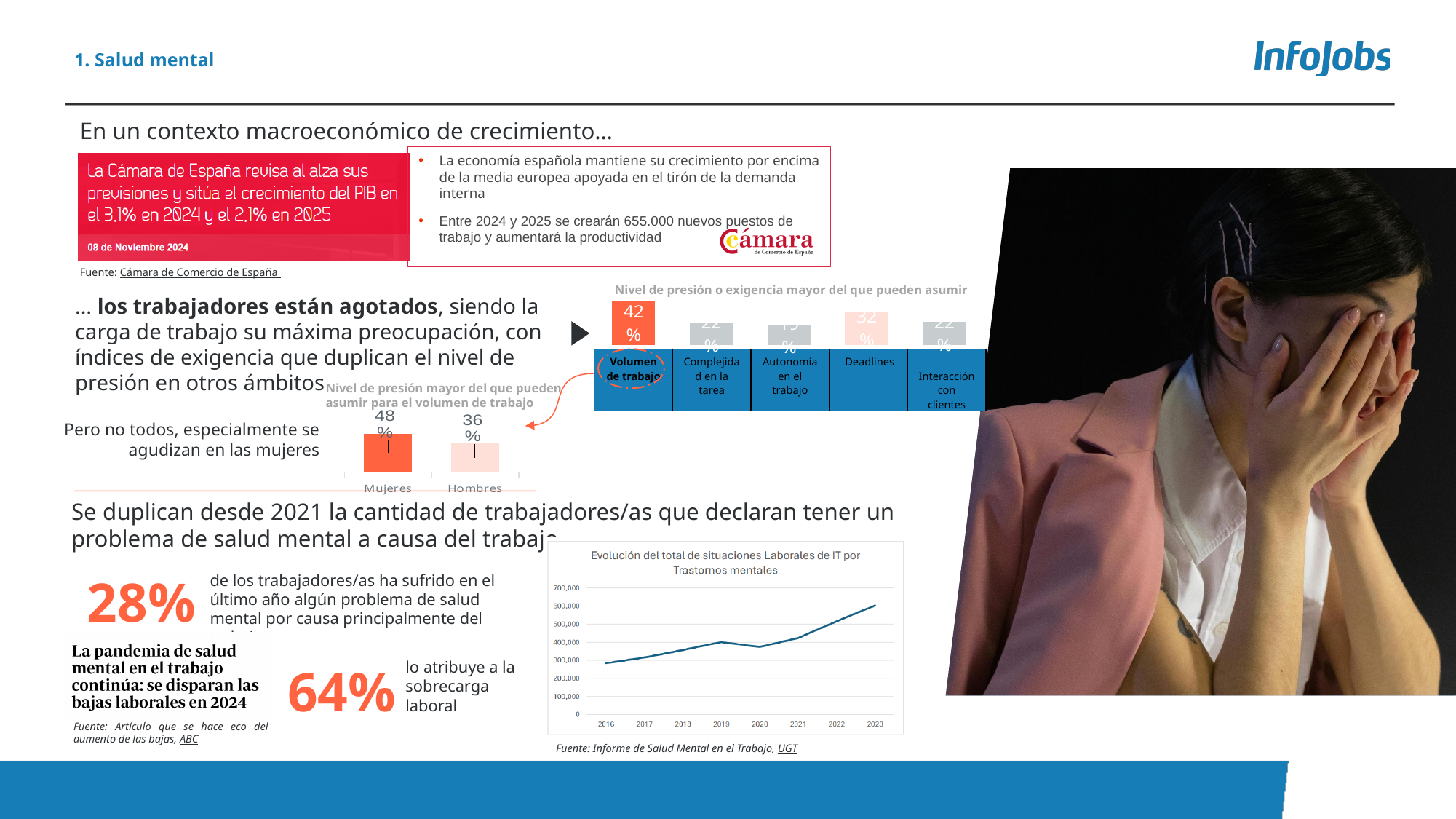
In the chart 'Nivel de presión mayor del que pueden asumir para el volumen de trabajo', what is the difference between Mujeres and Hombres? 12% In the chart 'Nivel de presión o exigencia mayor del que pueden asumir', what is the difference between Volumen de trabajo and Deadlines? 10% In the chart 'Nivel de presión mayor del que pueden asumir para el volumen de trabajo', what is the value for Hombres? 36% In the chart 'Nivel de presión mayor del que pueden asumir para el volumen de trabajo', which is larger, Mujeres or Hombres? Mujeres In the chart 'Nivel de presión o exigencia mayor del que pueden asumir', how many categories are shown? 5 In the chart 'Evolución del total de situaciones Laborales de IT por Trastornos mentales', is the value for 2023 greater or less than 500,000? greater In the chart 'Nivel de presión mayor del que pueden asumir para el volumen de trabajo', what is the value for Mujeres? 48% In the chart 'Nivel de presión o exigencia mayor del que pueden asumir', which category has the highest value? Volumen de trabajo In the chart 'Evolución del total de situaciones Laborales de IT por Trastornos mentales', do the values rise or fall from 2016 to 2023? Rise In the chart 'Nivel de presión o exigencia mayor del que pueden asumir', what is the value for Deadlines? 32% In the chart 'Nivel de presión o exigencia mayor del que pueden asumir', what is the value for Volumen de trabajo? 42% What kind of chart is 'Evolución del total de situaciones Laborales de IT por Trastornos mentales'? Line chart